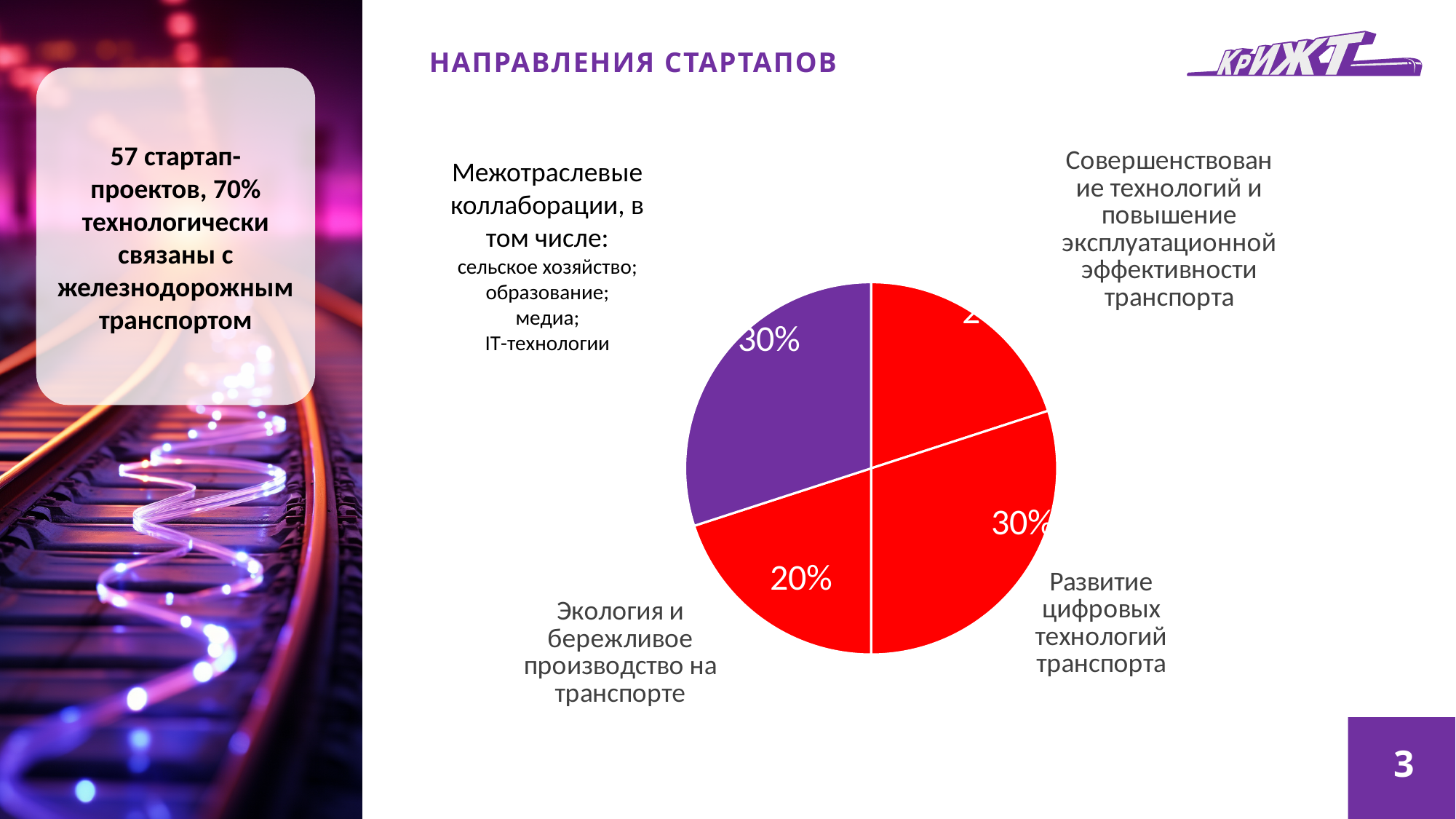
What kind of chart is shown on the slide? pie chart Which is larger: the slice for "Экология и бережливое производство на транспорте" or the slice for "Развитие цифровых технологий транспорта"? Развитие цифровых технологий транспорта What percentage is shown for "Экология и бережливое производство на транспорте"? 20% What share of the pie is labelled for "Межотраслевые коллаборации"? 30% What is the title of the slide containing the pie chart? НАПРАВЛЕНИЯ СТАРТАПОВ What percentage is shown for "Развитие цифровых технологий транспорта"? 30% What is the difference in percentage points between the "Развитие цифровых технологий транспорта" slice and the "Экология и бережливое производство на транспорте" slice? 10 percentage points What colour is the slice for "Межотраслевые коллаборации"? purple Which is larger: the slice for "Межотраслевые коллаборации" or the slice for "Экология и бережливое производство на транспорте"? Межотраслевые коллаборации How many slices does the pie chart have? 4